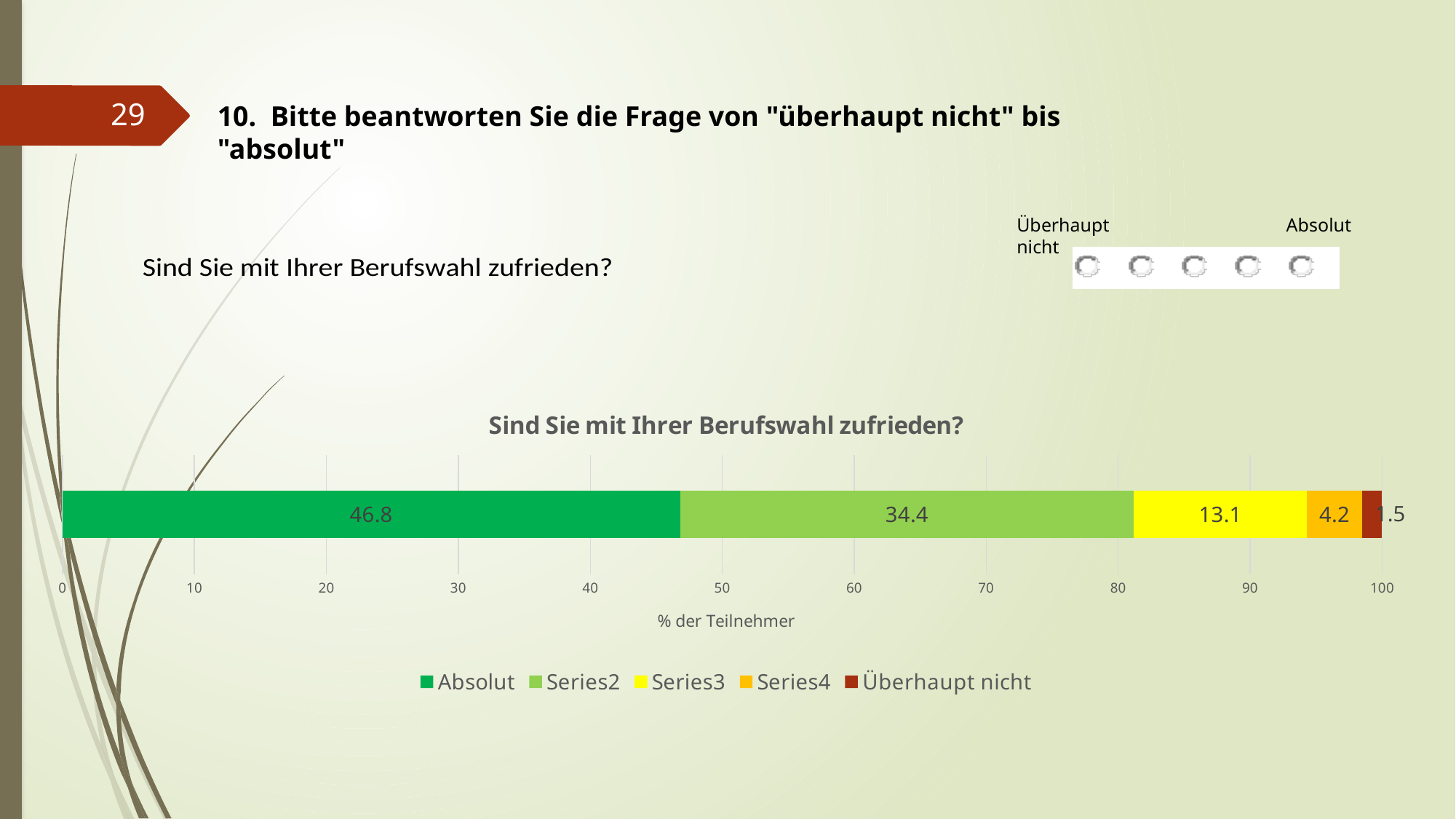
What is the difference between the Absolut value and the Series2 value? 12.4 What kind of chart is shown? Stacked bar chart What is the title of the chart? Sind Sie mit Ihrer Berufswahl zufrieden? How many series does the legend list? 5 What is the label of the horizontal axis? % der Teilnehmer Which series has the largest value? Absolut What is the value for Series3? 13.1 What is the value for Series4? 4.2 Which is larger, the value for Series3 or the value for Series4? Series3 What is the value for the Absolut series? 46.8 Which series has the smallest value? Überhaupt nicht What is the value for Series2? 34.4